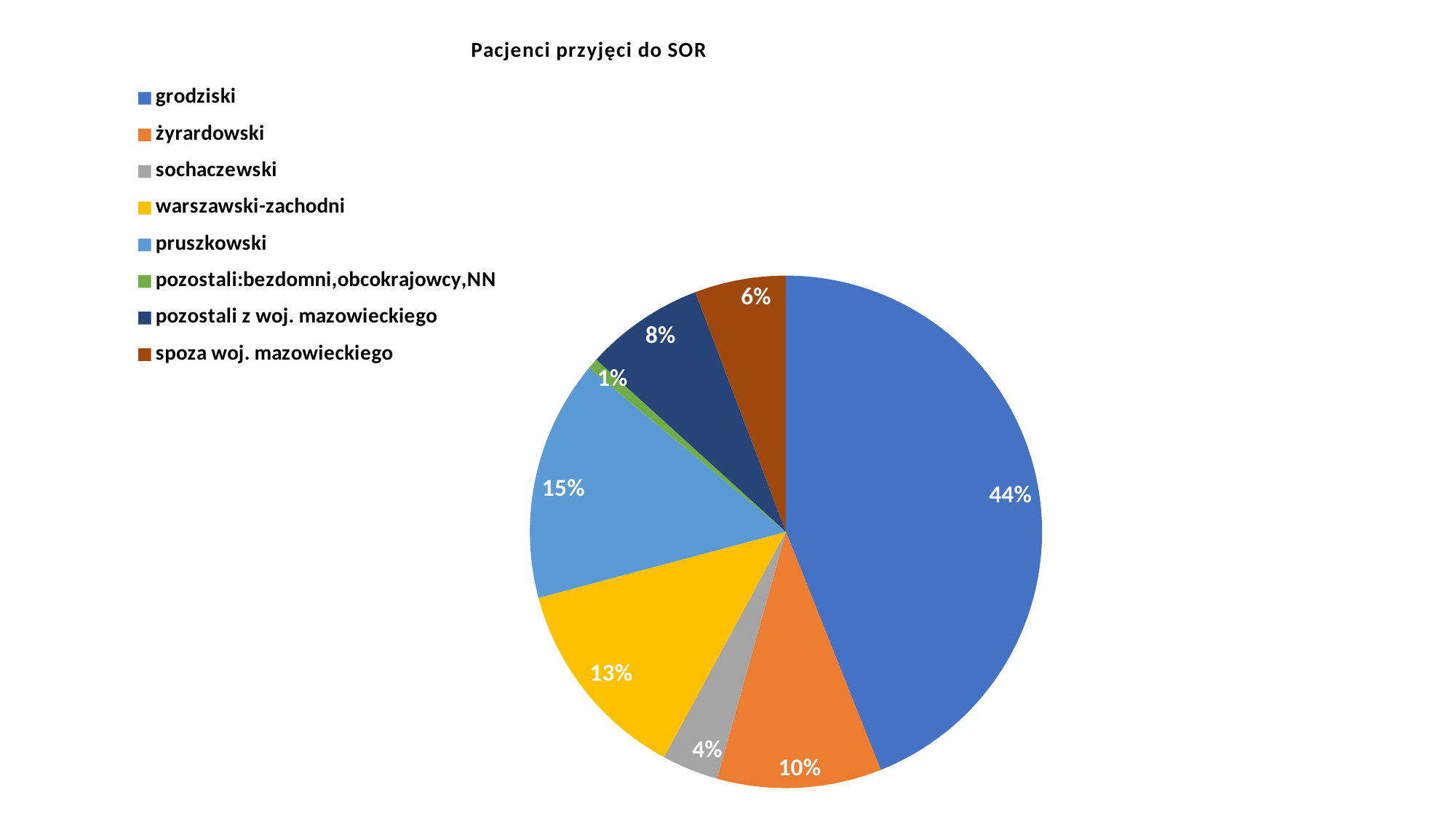
Which has a larger share, pozostali z woj. mazowieckiego or spoza woj. mazowieckiego? pozostali z woj. mazowieckiego What share of the pie does grodziski have? 44% Which category has the smallest share of the pie? pozostali:bezdomni,obcokrajowcy,NN What share of the pie does pruszkowski have? 15% How many categories does the pie chart have? 8 Which category has the largest share of the pie? grodziski What colour is the slice for warszawski-zachodni? yellow What is the difference in percentage points between żyrardowski and sochaczewski? 6 What type of chart is shown on the slide? pie chart What share of the pie does spoza woj. mazowieckiego have? 6% What is the title of the chart? Pacjenci przyjęci do SOR